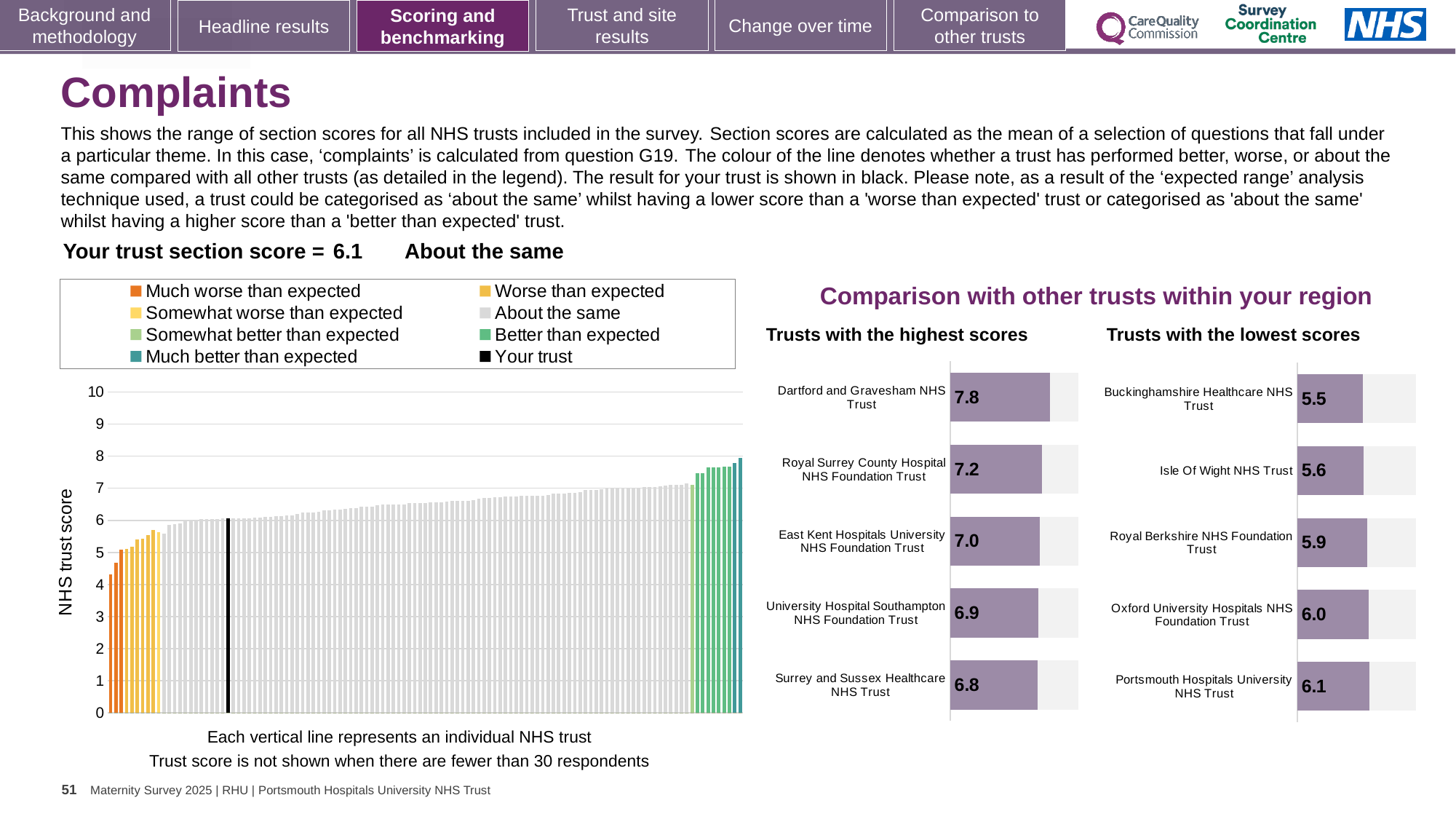
In the 'Trusts with the highest scores' chart, what is the difference between the scores of Dartford and Gravesham NHS Trust and Royal Surrey County Hospital NHS Foundation Trust? 0.6 In the 'Trusts with the lowest scores' chart, what is the difference between the scores of Portsmouth Hospitals University NHS Trust and Buckinghamshire Healthcare NHS Trust? 0.6 In the 'Trusts with the highest scores' chart, which trust has the lowest score? Surrey and Sussex Healthcare NHS Trust How many trusts are shown in the 'Trusts with the highest scores' chart? 5 In the 'Trusts with the lowest scores' chart, what is the score for Isle Of Wight NHS Trust? 5.6 What kind of chart is the 'NHS trust score' chart on the left of the slide? Bar chart In the 'NHS trust score' chart on the left, what is the section score for your trust (the black bar)? 6.1 In the 'Trusts with the highest scores' chart, what is the score for Dartford and Gravesham NHS Trust? 7.8 How many entries does the legend above the 'NHS trust score' chart list? 8 In the 'Trusts with the lowest scores' chart, which trust has the highest score? Portsmouth Hospitals University NHS Trust In the 'NHS trust score' chart on the left, do the bars rise or fall from left to right? Rise In the 'Trusts with the lowest scores' chart, which has the larger score: Royal Berkshire NHS Foundation Trust or Oxford University Hospitals NHS Foundation Trust? Oxford University Hospitals NHS Foundation Trust